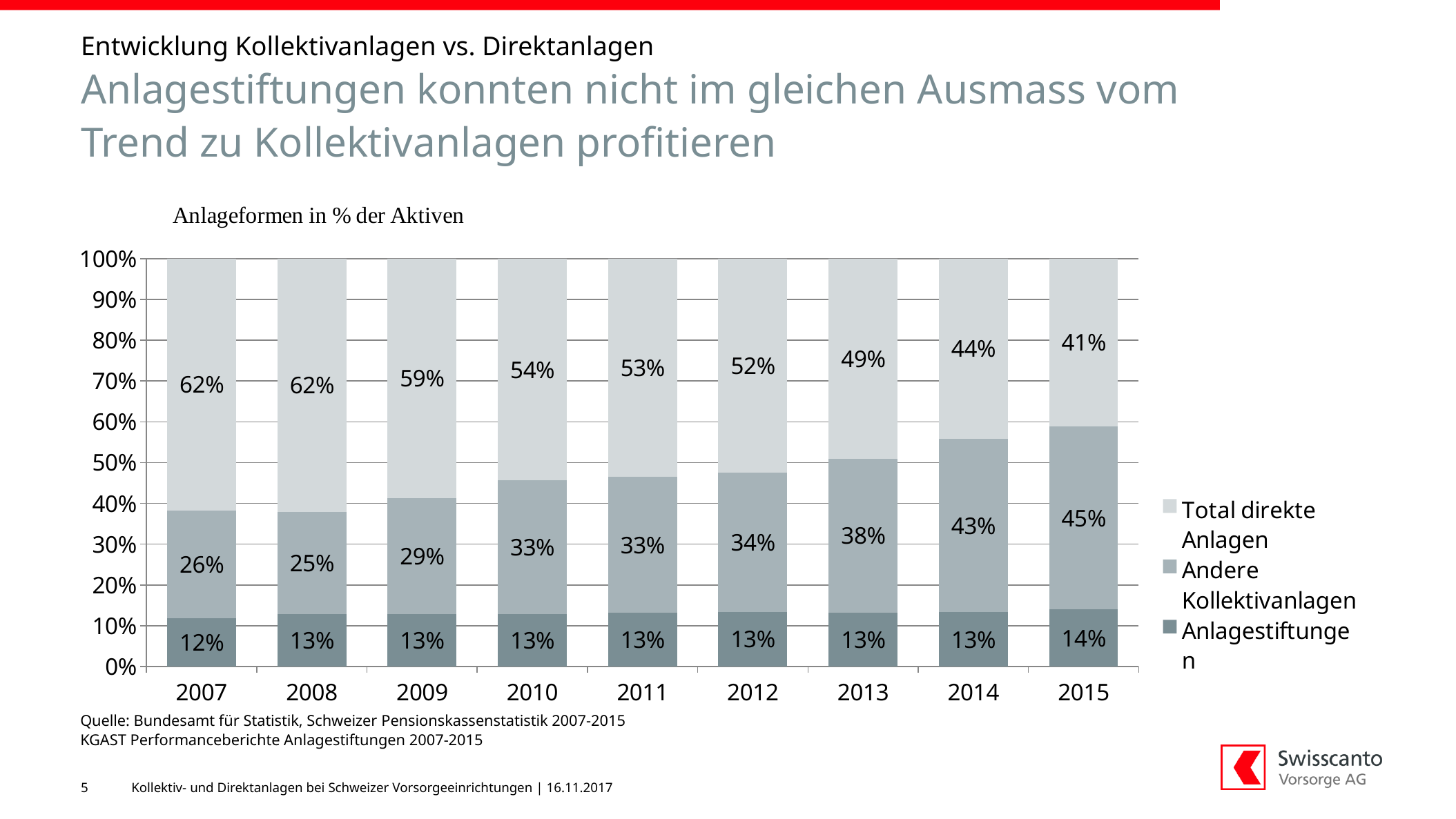
What is the title of the chart? Anlageformen in % der Aktiven How many years are shown on the x axis? 9 Does the Total direkte Anlagen share rise or fall from 2007 to 2015? Fall What is the value for Anlagestiftungen in 2015? 14% Which is larger in 2014: Total direkte Anlagen or Andere Kollektivanlagen? Total direkte Anlagen In which year is the Andere Kollektivanlagen share highest? 2015 What is the value for Total direkte Anlagen in 2007? 62% What is the value for Andere Kollektivanlagen in 2013? 38% What is the difference between the Total direkte Anlagen share in 2007 and in 2015? 21 percentage points In which year is the Total direkte Anlagen share lowest? 2015 How many series does the legend list? 3 What kind of chart is shown? Stacked bar chart